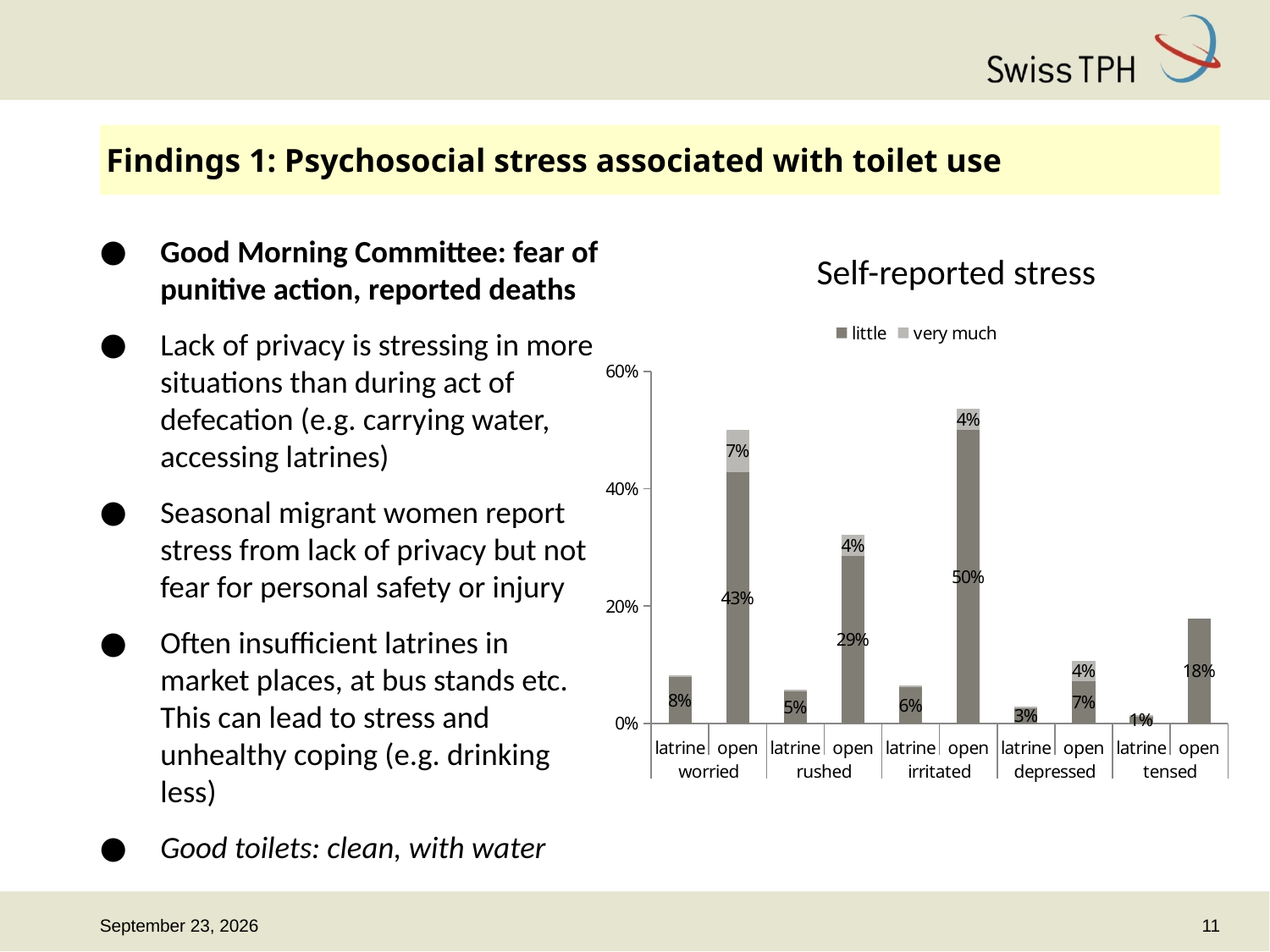
Which bar has the highest 'little' value? open, irritated What is the total of the stacked bar for open defecation in the depressed category? 11% Which bar has the lowest 'little' value? latrine, tensed What is the total of the stacked bar for open defecation in the worried category? 50% What is the 'little' value for open defecation in the rushed category? 29% What is the difference between the 'little' values for open defecation in the irritated and worried categories? 7% What is the 'little' value for open defecation in the worried category? 43% What is the title of the chart? Self-reported stress Which is larger: the 'little' value for open defecation in the rushed category or in the tensed category? rushed How many series does the legend list? 2 What is the 'little' value for latrine use in the tensed category? 1% What is the 'very much' value for open defecation in the irritated category? 4%